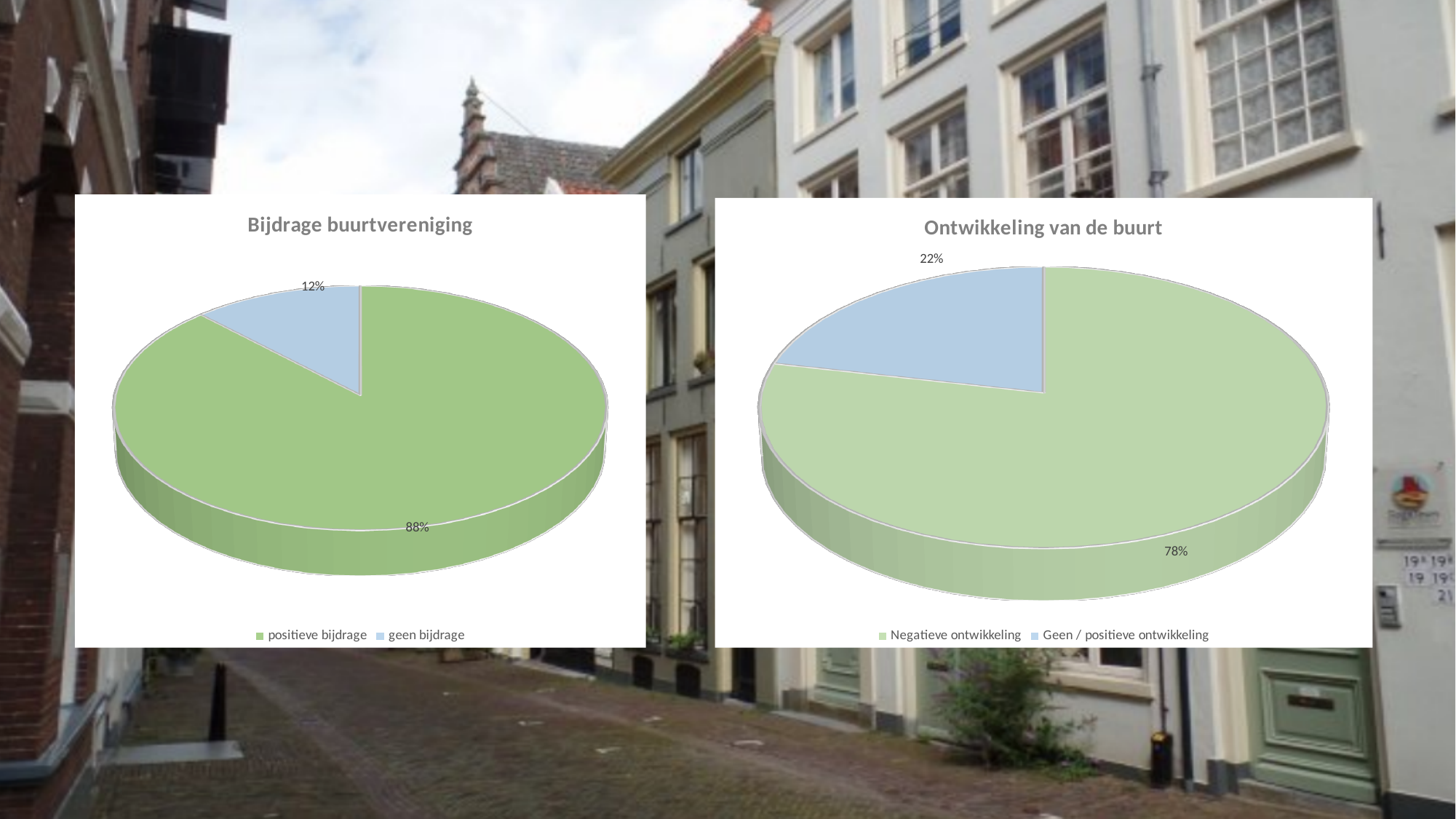
In the 'Ontwikkeling van de buurt' chart, which slice is the smallest? Geen / positieve ontwikkeling How many slices does the 'Bijdrage buurtvereniging' chart have? 2 What is the title of the chart on the right of the slide? Ontwikkeling van de buurt In the 'Bijdrage buurtvereniging' chart, what share is labelled for 'geen bijdrage'? 12% In the 'Bijdrage buurtvereniging' chart, which slice is the largest? positieve bijdrage In the 'Bijdrage buurtvereniging' chart, what share is labelled for 'positieve bijdrage'? 88% Which is larger: the 'geen bijdrage' share in the left chart or the 'Geen / positieve ontwikkeling' share in the right chart? Geen / positieve ontwikkeling In the 'Ontwikkeling van de buurt' chart, what is the difference in percentage points between 'Negatieve ontwikkeling' and 'Geen / positieve ontwikkeling'? 56 In the 'Bijdrage buurtvereniging' chart, what is the difference in percentage points between 'positieve bijdrage' and 'geen bijdrage'? 76 What type of chart is 'Ontwikkeling van de buurt'? pie chart In the 'Ontwikkeling van de buurt' chart, what share is labelled for 'Geen / positieve ontwikkeling'? 22% In the 'Ontwikkeling van de buurt' chart, what share is labelled for 'Negatieve ontwikkeling'? 78%